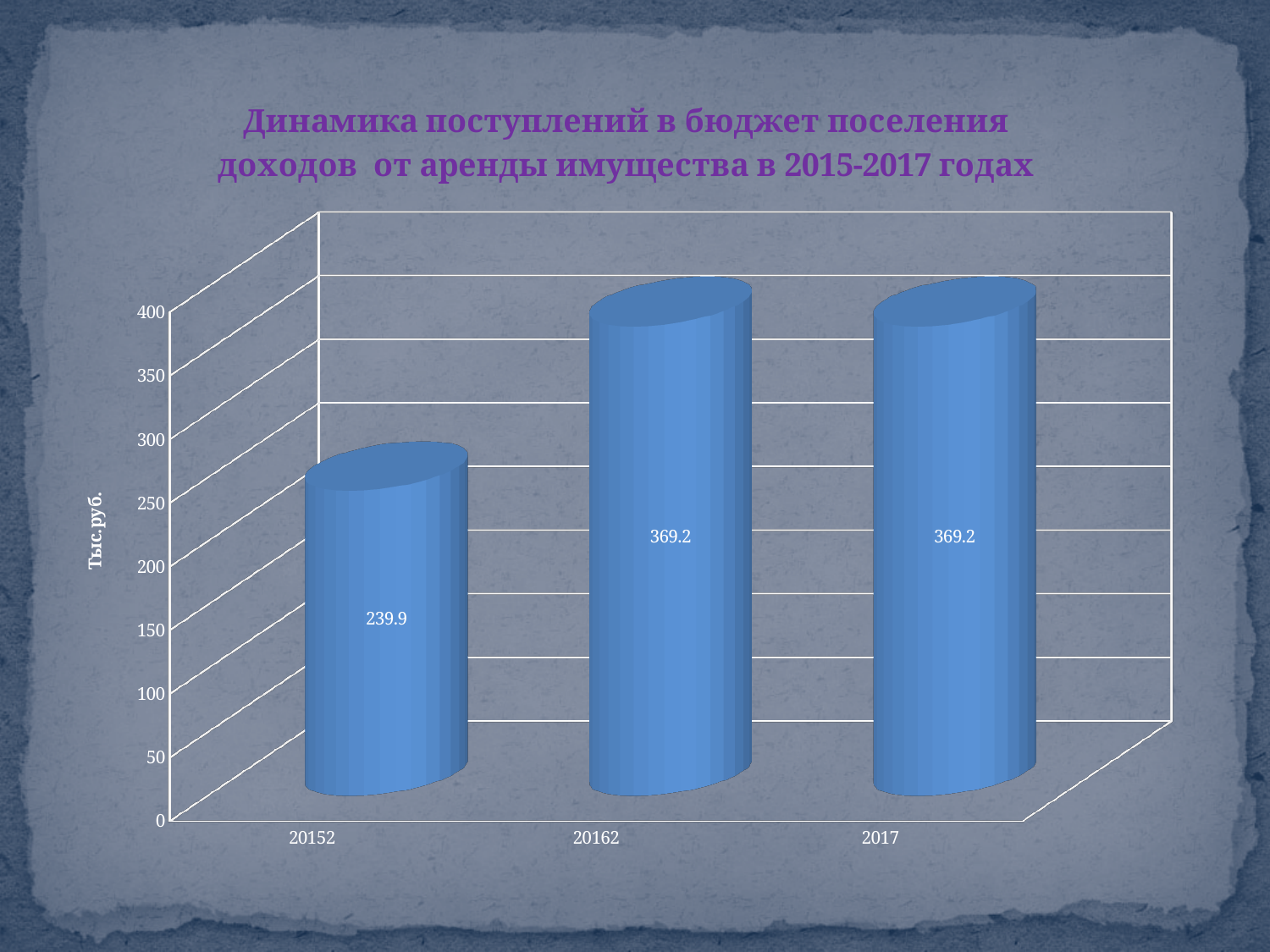
Is the value for 20152 greater or less than 300? less Are the values for 20162 and 2017 equal? Yes What is the value for 2017? 369.2 How many categories are shown on the x axis? 3 Which category has the lowest value? 20152 What is the value for 20162? 369.2 What is the label on the vertical axis? Тыс.руб. What is the value for 20152? 239.9 What is the difference between the values for 20162 and 20152? 129.3 Do the values rise or fall from 20152 to 20162? Rise What kind of chart is shown on the slide? Bar chart Which is larger, the value for 20152 or the value for 2017? 2017